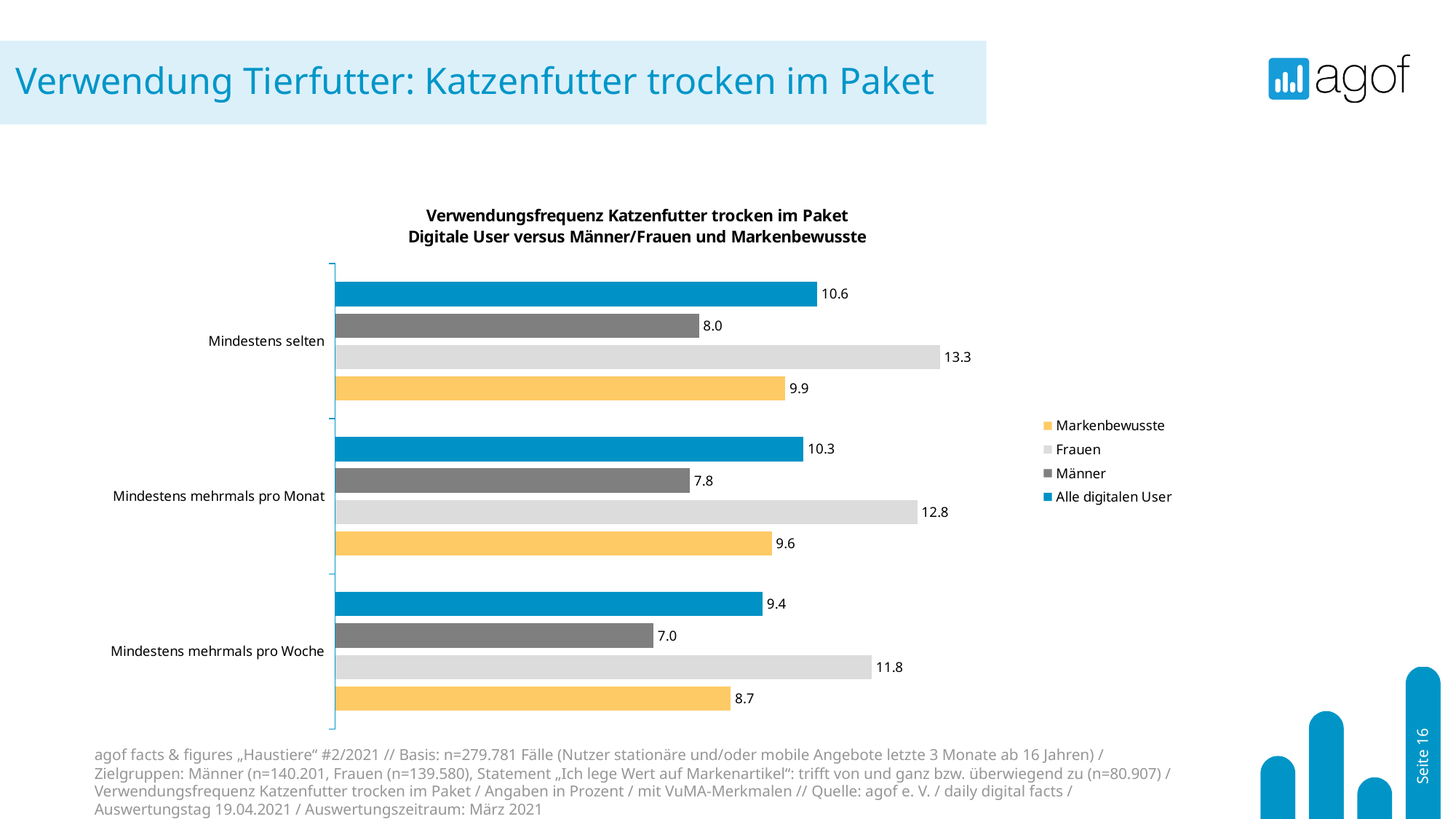
Which colour represents the Frauen series in the chart? Light grey How many series does the legend list? 4 What kind of chart is shown on the slide? Bar chart What is the value for Männer in the 'Mindestens mehrmals pro Woche' category? 7.0 How many categories are shown on the chart? 3 Which is larger: the Markenbewusste value for 'Mindestens selten' or the Alle digitalen User value for 'Mindestens selten'? Alle digitalen User What is the value for Alle digitalen User in the 'Mindestens mehrmals pro Monat' category? 10.3 What is the value for Frauen in the 'Mindestens selten' category? 13.3 What is the difference between the Frauen and Männer values in the 'Mindestens mehrmals pro Woche' category? 4.8 What is the value for Markenbewusste in the 'Mindestens mehrmals pro Woche' category? 8.7 Which series has the lowest value in the 'Mindestens mehrmals pro Monat' category? Männer Which series has the highest value in the 'Mindestens selten' category? Frauen